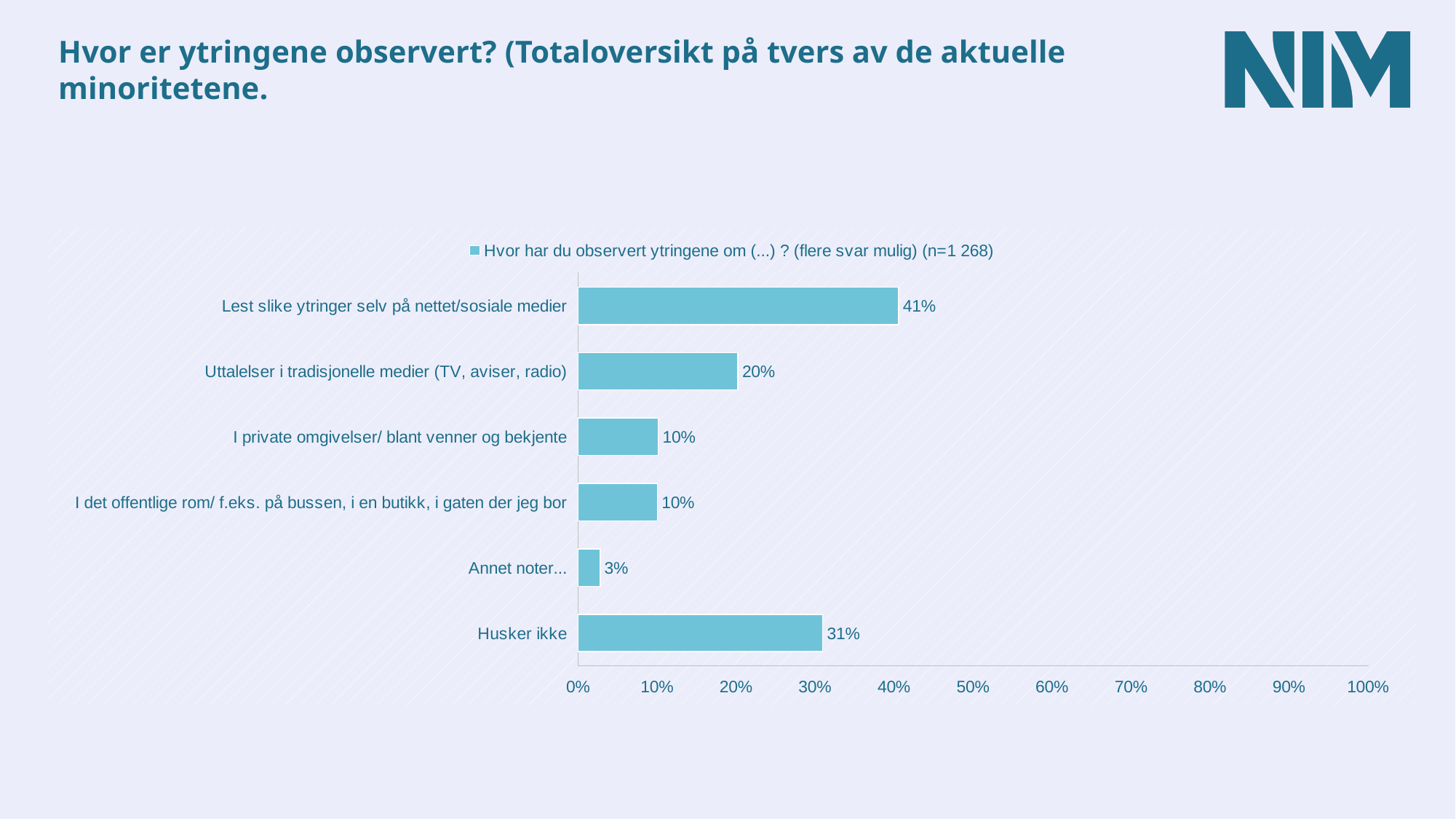
What is the value for "Uttalelser i tradisjonelle medier (TV, aviser, radio)"? 20% What is the difference between "Lest slike ytringer selv på nettet/sosiale medier" and "Husker ikke"? 10% What is the value for "Husker ikke"? 31% What kind of chart is shown on the slide? Bar chart What is the value for "Lest slike ytringer selv på nettet/sosiale medier"? 41% Is the value for "Husker ikke" greater or less than 40%? less Which category has the lowest value? Annet noter... What is the legend entry of the chart? Hvor har du observert ytringene om (...) ? (flere svar mulig) (n=1 268) Which is larger: "Uttalelser i tradisjonelle medier (TV, aviser, radio)" or "Husker ikke"? Husker ikke How many categories are shown in the chart? 6 Which category has the highest value? Lest slike ytringer selv på nettet/sosiale medier What is the value for "Annet noter..."? 3%